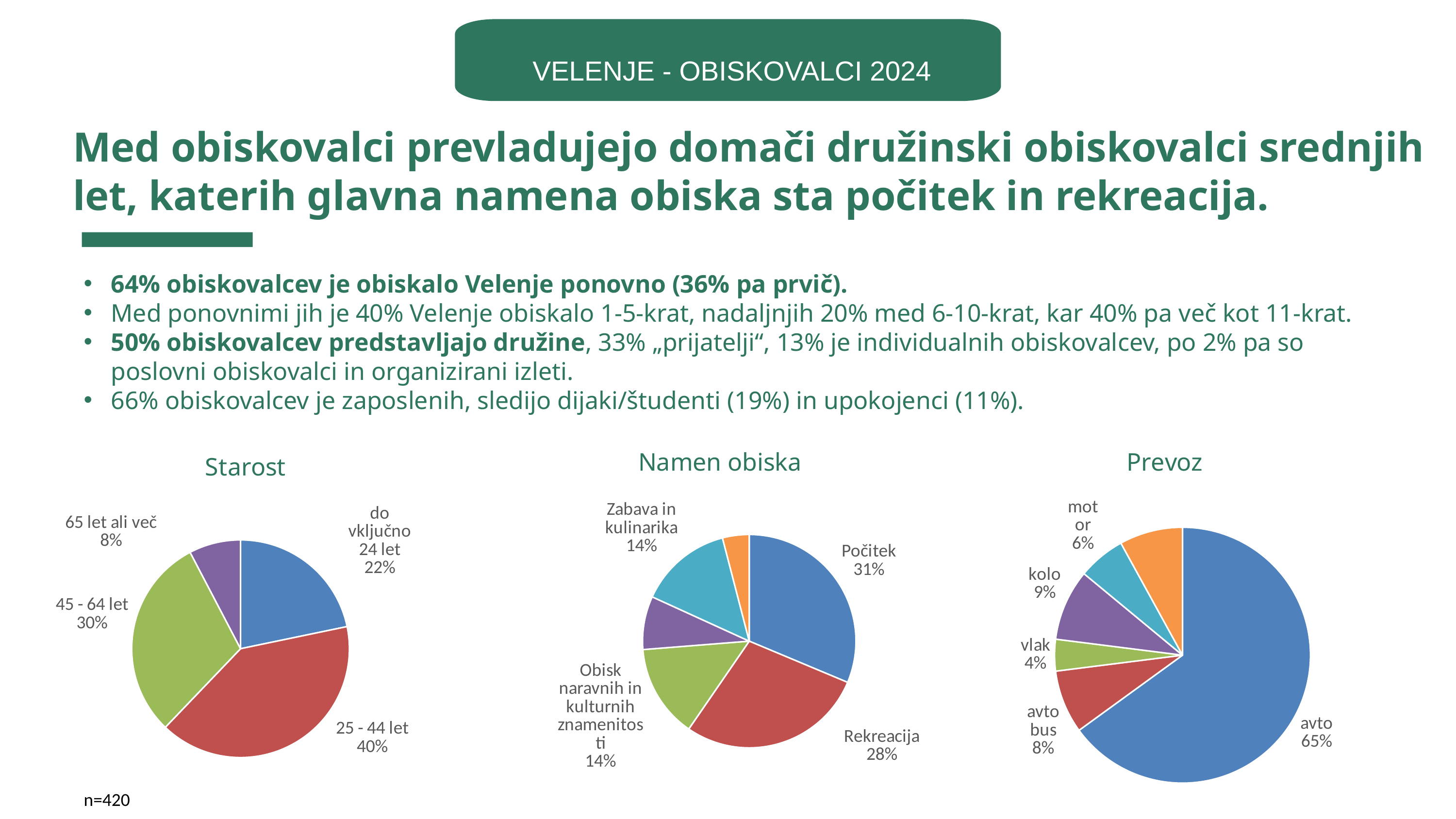
In the Namen obiska chart, what share is Rekreacija? 28% In the Namen obiska chart, what share is Počitek? 31% In the Prevoz chart, which is larger, kolo or avto bus? kolo In the Prevoz chart, what share of visitors came by vlak? 4% In the Starost chart, which age group has the largest share? 25 - 44 let In the Namen obiska chart, which is larger, Počitek or Zabava in kulinarika? Počitek In the Starost chart, which age group has the smallest share? 65 let ali več In the Starost chart, what share of visitors are 65 let ali več? 8% In the Starost chart, what share of visitors are aged 25 - 44 let? 40% What type of chart is the Prevoz chart? pie chart In the Prevoz chart, what share of visitors came by avto? 65% In the Starost chart, what is the difference between the shares of 45 - 64 let and do vključno 24 let? 8%